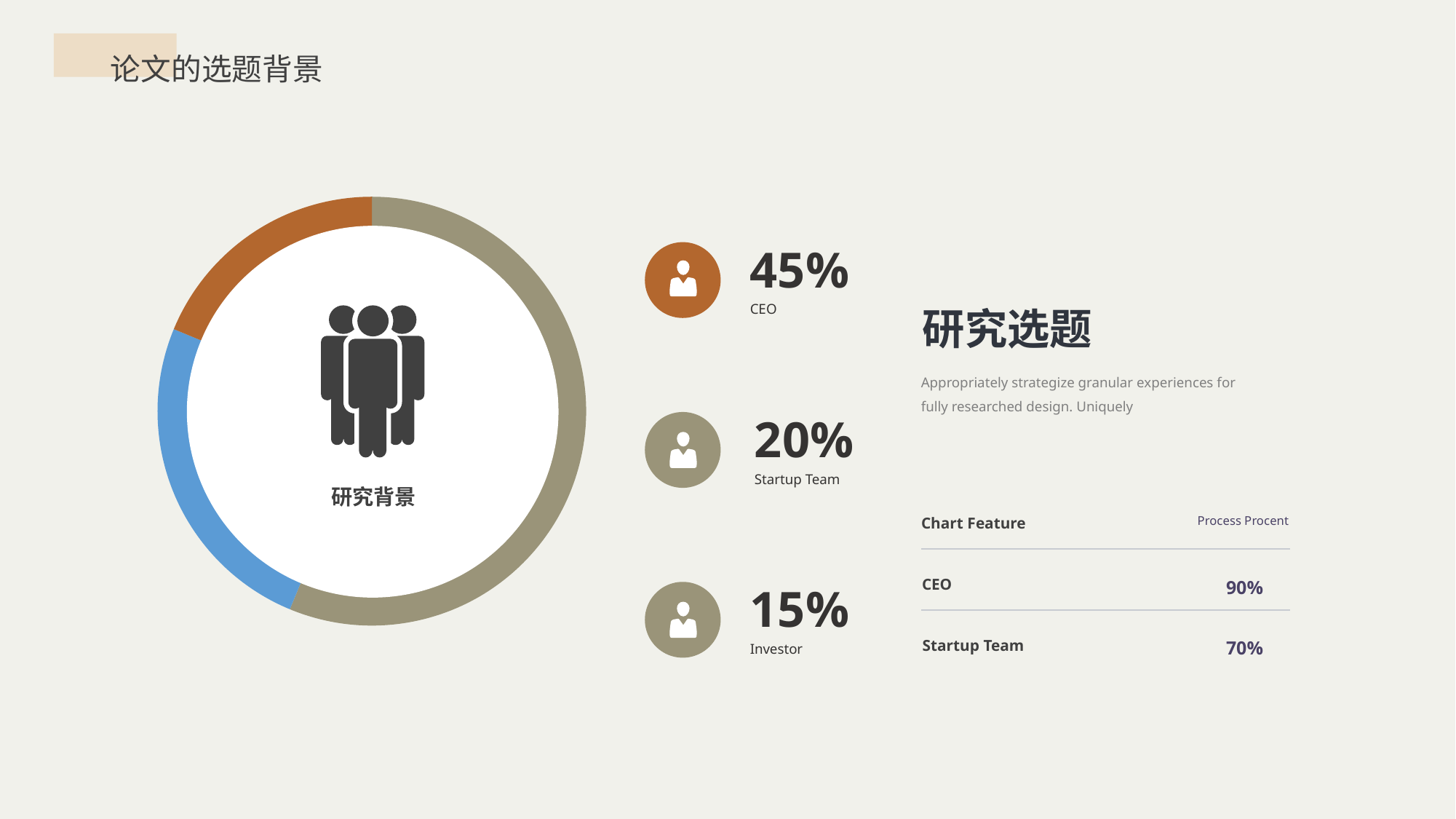
How many segments does the donut chart on the left have? 3 What percentage is listed next to the Startup Team icon beside the donut chart? 20% What kind of chart is shown on the left of the slide? Donut (pie) chart Among the three percentages listed beside the donut chart (CEO, Startup Team, Investor), which category has the highest value? CEO What percentage is listed next to the Investor icon beside the donut chart? 15% What text is printed in the centre of the donut chart? 研究背景 Among the three percentages listed beside the donut chart (CEO, Startup Team, Investor), which category has the lowest value? Investor What is the difference between the percentages listed for CEO and Startup Team beside the donut chart? 25% Which colour segment of the donut chart is the smallest? Orange What percentage is listed next to the CEO icon beside the donut chart? 45% Which is larger, the percentage listed for Startup Team or for Investor beside the donut chart? Startup Team Which colour segment of the donut chart is the largest? Olive/khaki